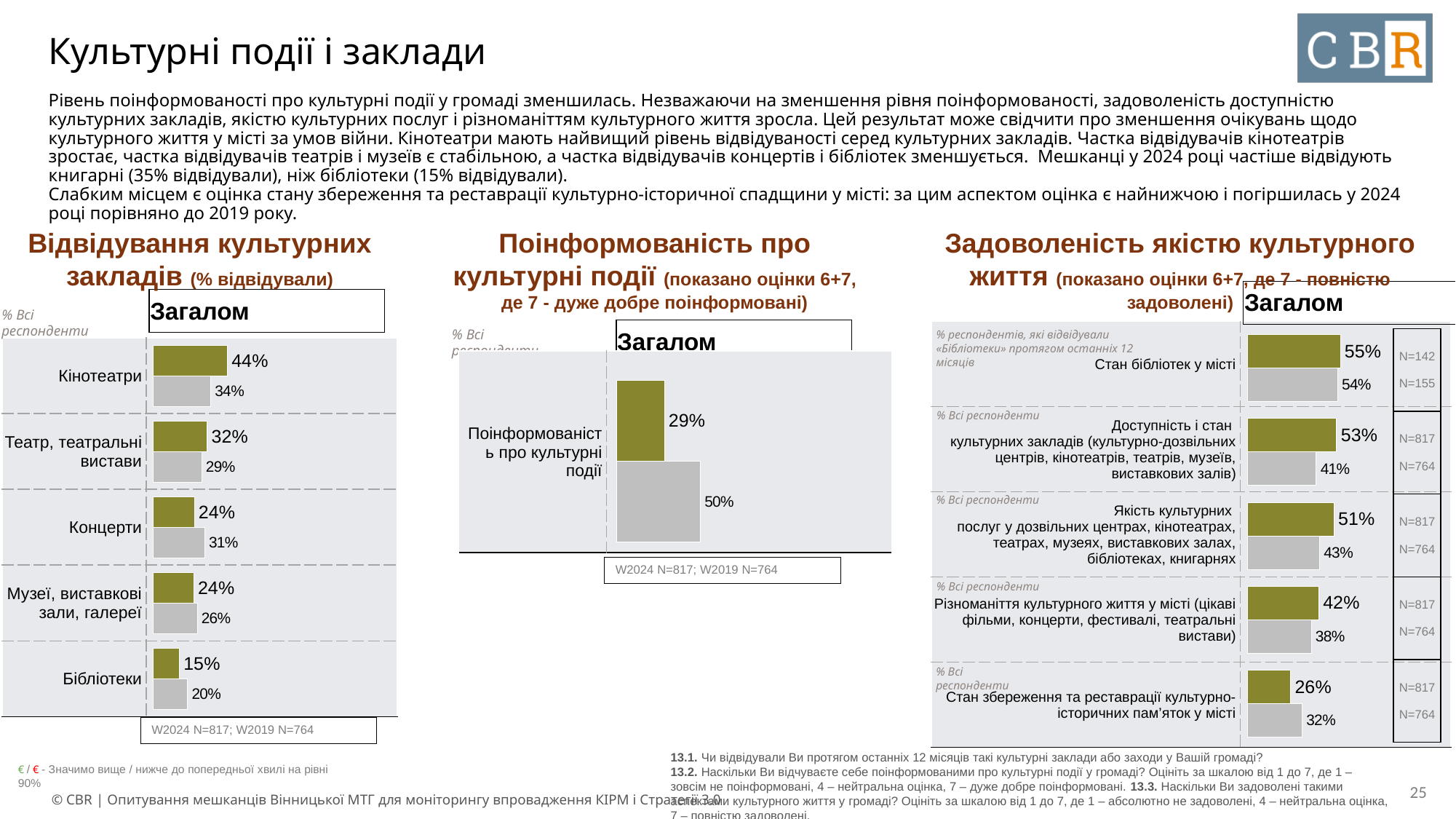
In the chart 'Відвідування культурних закладів', what is the 2019 (grey) value for Бібліотеки? 20% In the chart 'Поінформованість про культурні події', what is the 2024 (olive) value? 29% What type of chart is 'Відвідування культурних закладів'? Bar chart In the chart 'Відвідування культурних закладів', what is the difference between the 2024 and 2019 values for Кінотеатри? 10 percentage points In the chart 'Задоволеність якістю культурного життя', what is the difference between the 2024 and 2019 values for 'Доступність і стан культурних закладів'? 12 percentage points In the chart 'Задоволеність якістю культурного життя', what is the 2024 (olive) value for 'Стан збереження та реставрації культурно-історичних пам'яток у місті'? 26% In the chart 'Задоволеність якістю культурного життя', which category has the highest 2024 (olive) value? Стан бібліотек у місті How many categories are shown in the chart 'Відвідування культурних закладів'? 5 In the chart 'Поінформованість про культурні події', which is larger: the 2024 (olive) value or the 2019 (grey) value? 2019 (grey), 50% In the chart 'Відвідування культурних закладів', which category has the highest 2024 (olive) value? Кінотеатри In the chart 'Відвідування культурних закладів', which category has the lowest 2024 (olive) value? Бібліотеки In the chart 'Відвідування культурних закладів', what is the 2024 (olive) value for Кінотеатри? 44%